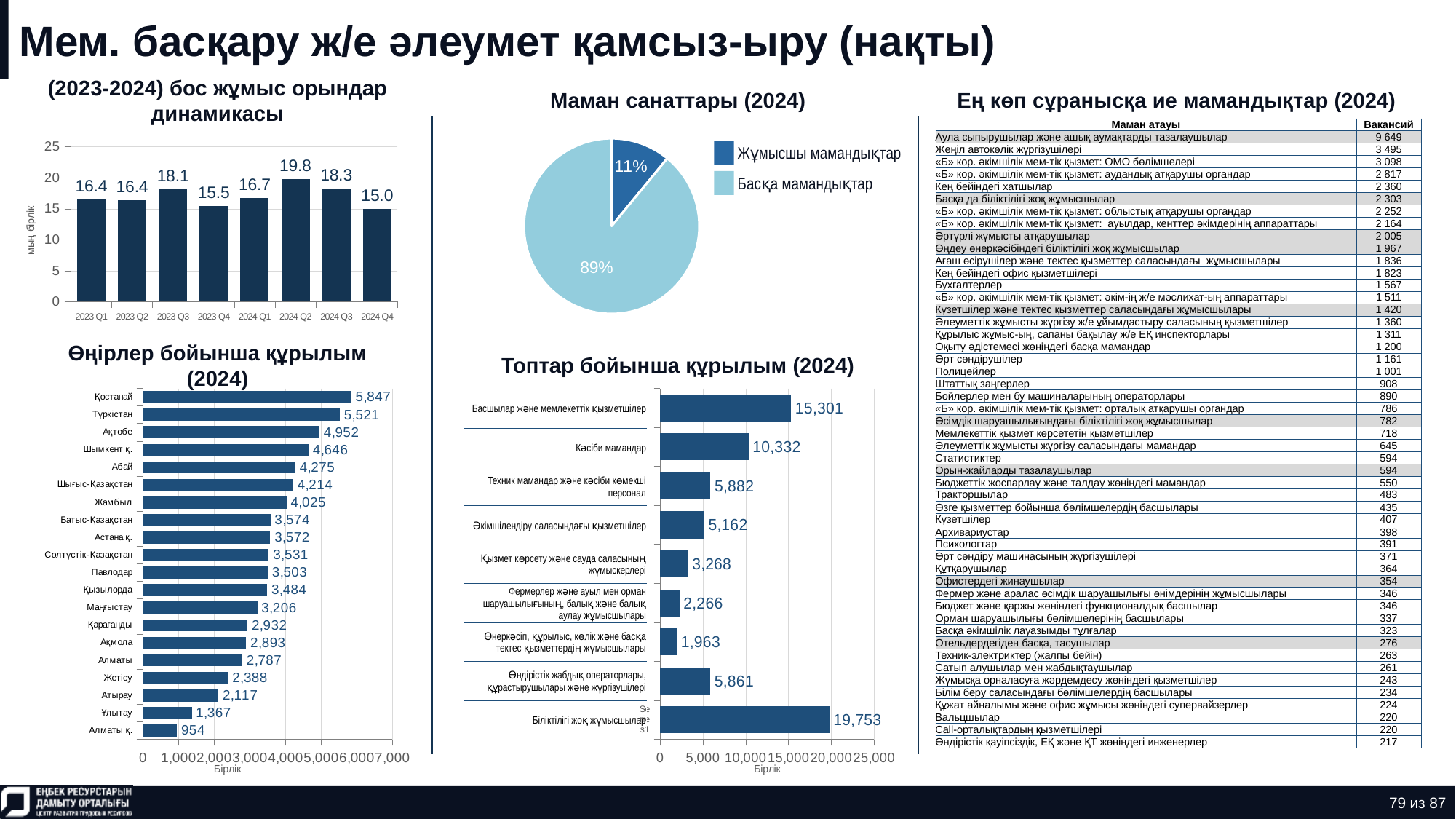
In the chart '(2023-2024) бос жұмыс орындар динамикасы', what is the value for 2024 Q2? 19.8 In the chart 'Өңірлер бойынша құрылым (2024)', which region has the highest value? Қостанай How many entries does the legend of the pie chart 'Маман санаттары (2024)' list? 2 In the chart 'Топтар бойынша құрылым (2024)', what is the value for 'Кәсіби мамандар'? 10,332 In the chart '(2023-2024) бос жұмыс орындар динамикасы', what is the difference between 2024 Q2 and 2024 Q4? 4.8 In the chart 'Топтар бойынша құрылым (2024)', which group has the highest value? Біліктілігі жоқ жұмысшылар In the chart '(2023-2024) бос жұмыс орындар динамикасы', how many quarters are plotted? 8 In the chart 'Өңірлер бойынша құрылым (2024)', which is larger: Ақмола or Алматы? Ақмола In the chart 'Өңірлер бойынша құрылым (2024)', what is the value for Түркістан? 5,521 In the pie chart 'Маман санаттары (2024)', what share is 'Жұмысшы мамандықтар'? 11% In the chart '(2023-2024) бос жұмыс орындар динамикасы', which quarter has the lowest value? 2024 Q4 What kind of chart is 'Топтар бойынша құрылым (2024)'? Bar chart